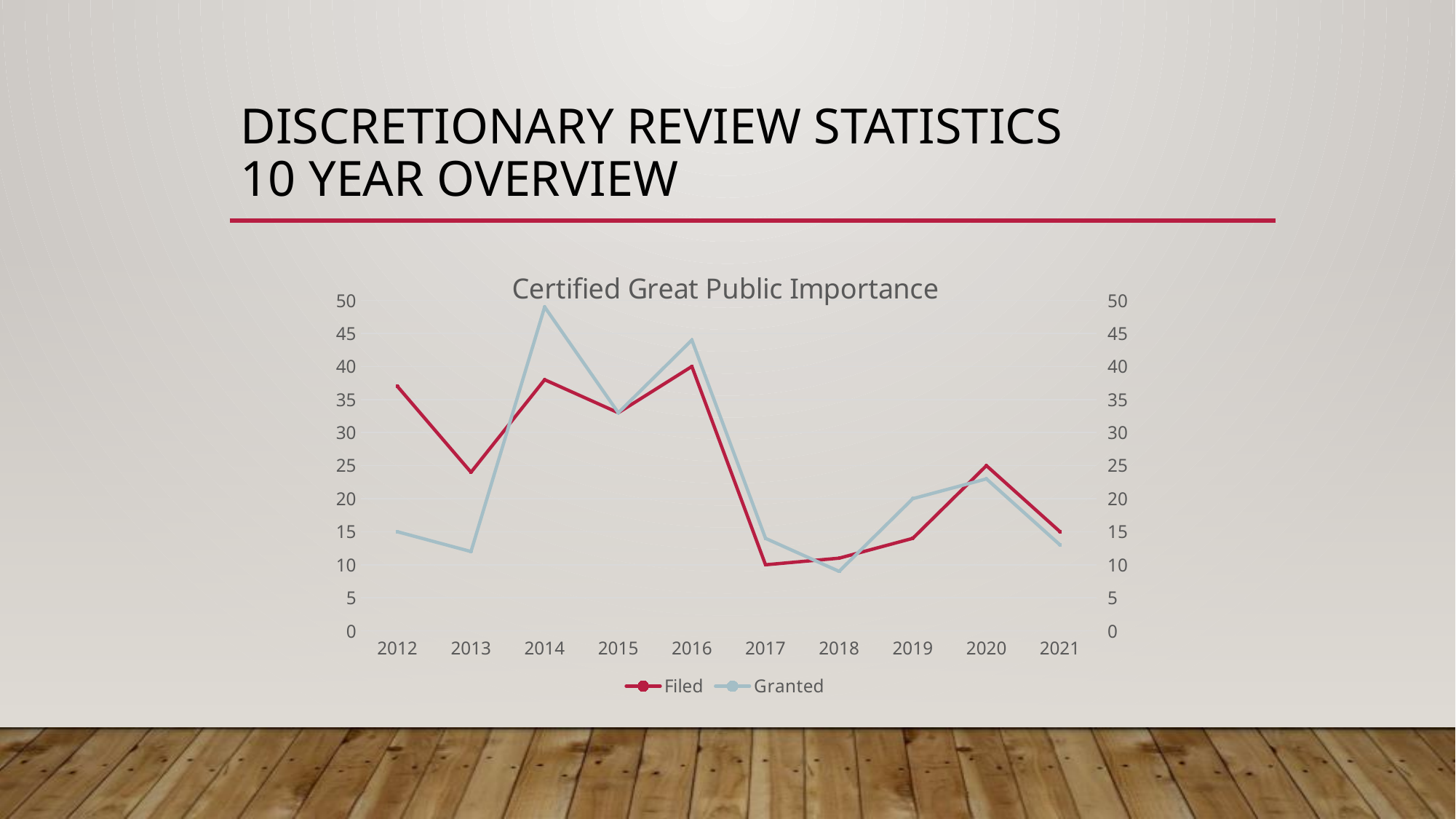
In which year is the Granted series highest? 2014 How many years are plotted along the x axis? 10 What kind of chart is shown on the slide? line chart How many series does the legend list? 2 Is the Filed value for 2012 greater or less than 35? greater Is the Granted value for 2013 greater or less than 15? less In which year is the Granted series lowest? 2018 In 2012, which is larger, Filed or Granted? Filed In which year is the Filed series lowest? 2017 In 2014, which is larger, Filed or Granted? Granted What is the title of the chart? Certified Great Public Importance In which year is the Filed series highest? 2016